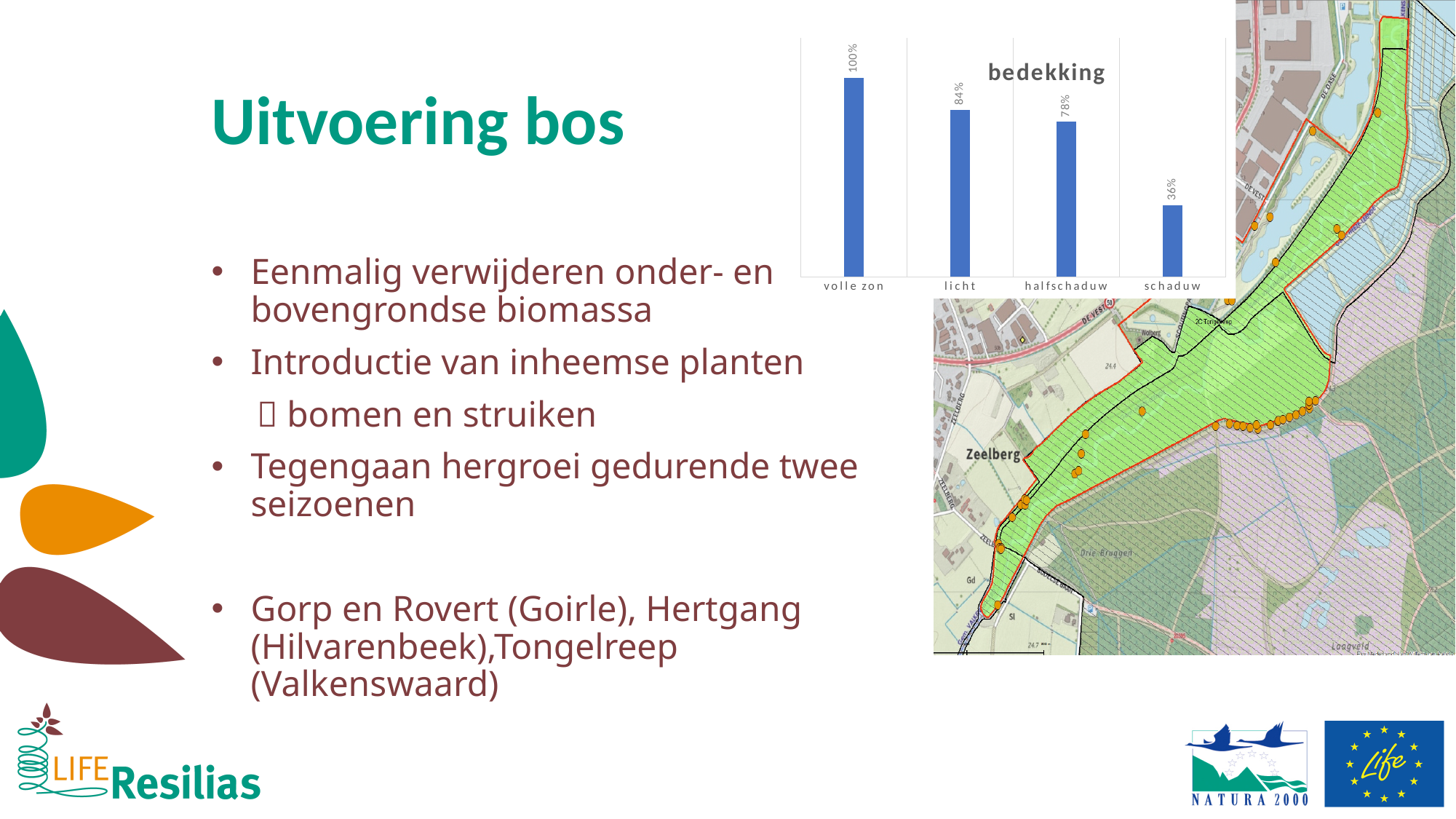
What is the value for 'licht' in the 'bedekking' chart? 84% Which category has the highest value in the 'bedekking' chart? volle zon What is the value for 'volle zon' in the 'bedekking' chart? 100% Do the values in the 'bedekking' chart rise or fall from left to right along the x axis? fall How many categories are shown in the 'bedekking' chart? 4 What is the value for 'schaduw' in the 'bedekking' chart? 36% What kind of chart is the 'bedekking' chart? bar chart What is the difference between the values for 'volle zon' and 'halfschaduw' in the 'bedekking' chart? 22% Which category has the lowest value in the 'bedekking' chart? schaduw What is the value for 'halfschaduw' in the 'bedekking' chart? 78% In the 'bedekking' chart, which is larger: the value for 'licht' or the value for 'halfschaduw'? licht What is the difference between the values for 'licht' and 'schaduw' in the 'bedekking' chart? 48%